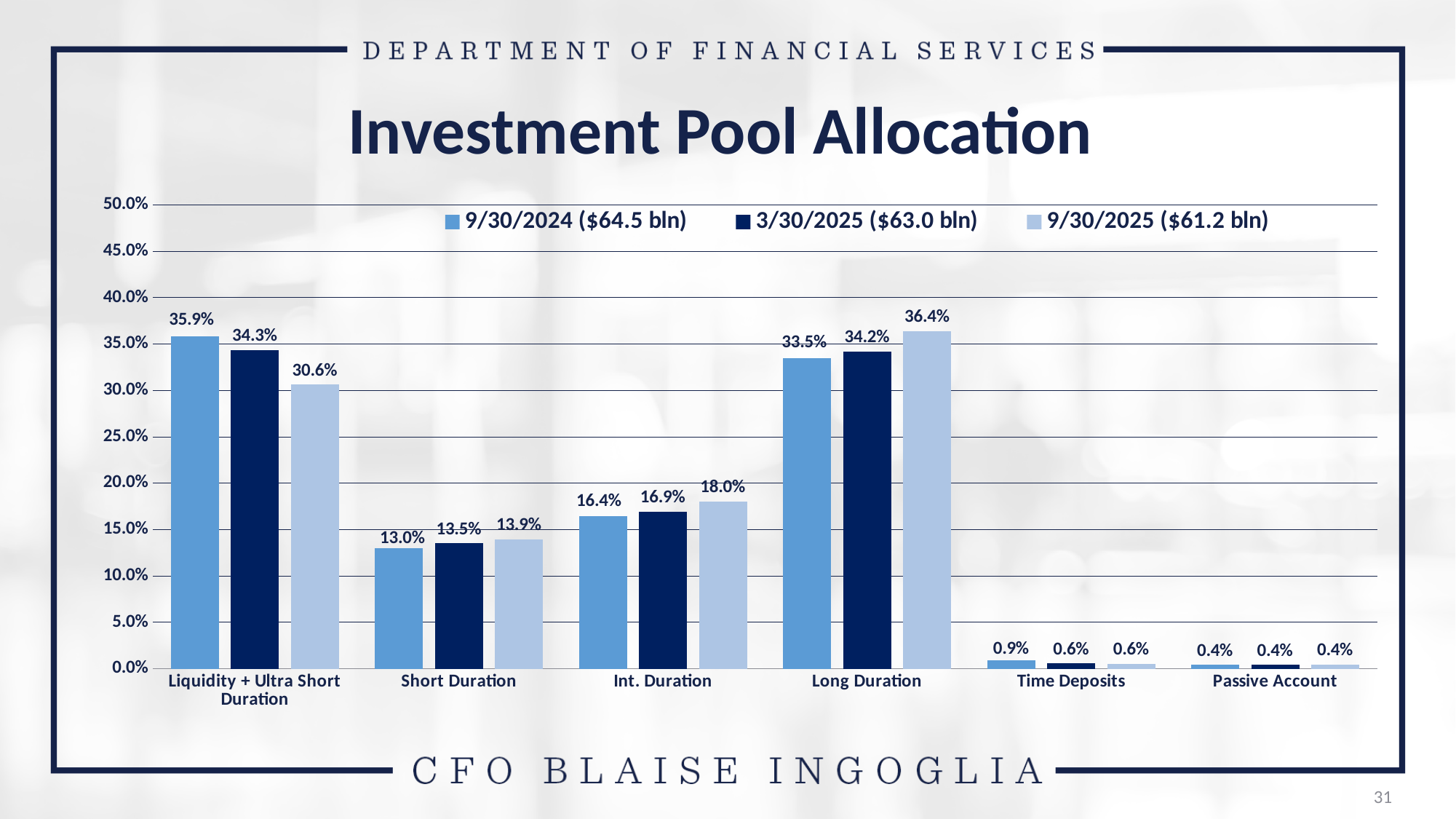
Which is larger for Short Duration: the 9/30/2024 ($64.5 bln) value or the 9/30/2025 ($61.2 bln) value? 9/30/2025 ($61.2 bln) What is the title of the chart? Investment Pool Allocation Which category has the lowest value in the 9/30/2024 ($64.5 bln) series? Passive Account Is the 3/30/2025 ($63.0 bln) value for Long Duration greater or less than 30.0%? greater Which category has the highest value in the 9/30/2025 ($61.2 bln) series? Long Duration How many series does the legend list? 3 What kind of chart is shown on the slide? Bar chart What is the value for Int. Duration in the 3/30/2025 ($63.0 bln) series? 16.9% What is the difference between the 9/30/2024 ($64.5 bln) and 9/30/2025 ($61.2 bln) values for Liquidity + Ultra Short Duration? 5.3% What is the value for Liquidity + Ultra Short Duration in the 9/30/2024 ($64.5 bln) series? 35.9% What is the value for Long Duration in the 9/30/2025 ($61.2 bln) series? 36.4% How many categories are shown on the x axis? 6